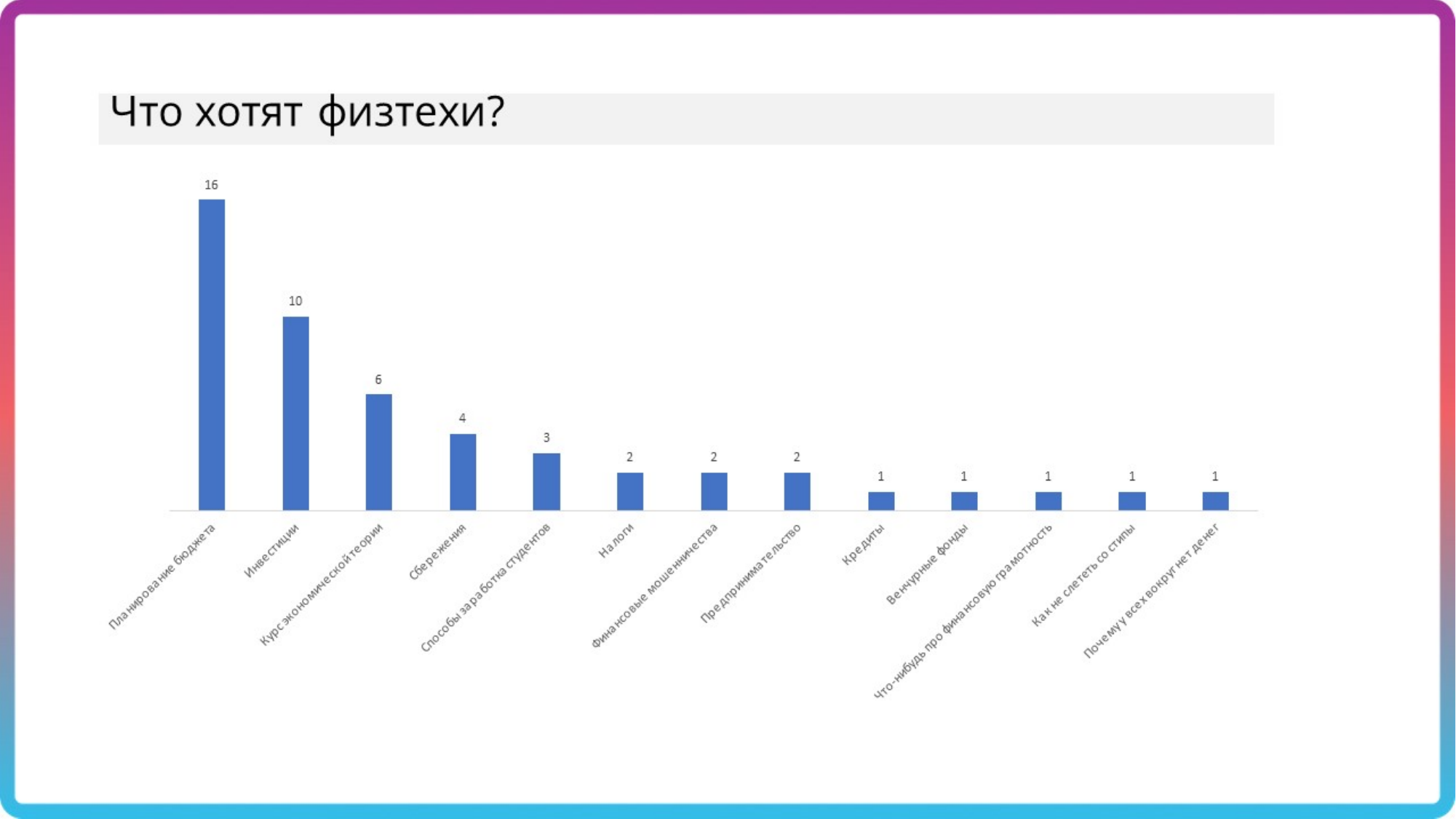
Which is larger, the value for Способы заработка студентов or the value for Кредиты? Способы заработка студентов What is the title of the slide? Что хотят физтехи? What value is shown for Курс экономической теории? 6 What kind of chart is shown on the slide? Bar chart What is the difference between the values for Инвестиции and Сбережения? 6 What value is shown for Налоги? 2 What value is shown for Планирование бюджета? 16 What value is shown for Инвестиции? 10 How many categories are shown on the chart? 13 Which category has the highest value? Планирование бюджета What value is shown for Сбережения? 4 What is the difference between the values for Планирование бюджета and Инвестиции? 6